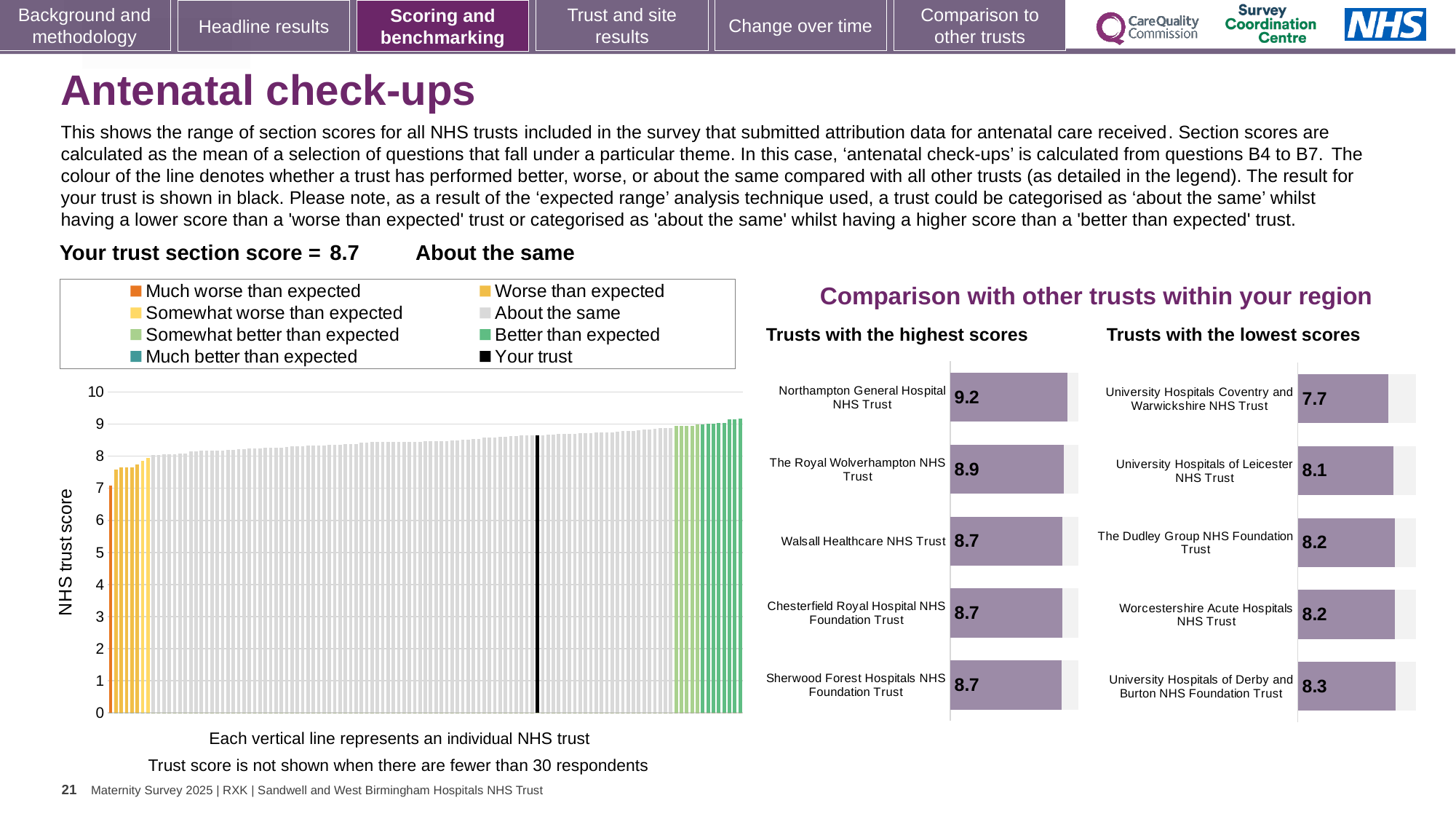
In the 'Trusts with the lowest scores' chart, what is the difference between the scores of University Hospitals of Derby and Burton NHS Foundation Trust and University Hospitals Coventry and Warwickshire NHS Trust? 0.6 What kind of chart is the main 'NHS trust score' chart on the left? Bar chart In the 'Trusts with the highest scores' chart, which trust has the highest score? Northampton General Hospital NHS Trust In the main 'NHS trust score' chart, do the trust scores rise or fall from left to right? Rise In the 'Trusts with the highest scores' chart, what is the difference between the scores of Northampton General Hospital NHS Trust and The Royal Wolverhampton NHS Trust? 0.3 In the 'Trusts with the lowest scores' chart, what is the score for University Hospitals Coventry and Warwickshire NHS Trust? 7.7 In the 'Trusts with the highest scores' chart, what is the score for Northampton General Hospital NHS Trust? 9.2 In the 'Trusts with the lowest scores' chart, which has the larger score: University Hospitals of Leicester NHS Trust or The Dudley Group NHS Foundation Trust? The Dudley Group NHS Foundation Trust How many entries does the legend of the main 'NHS trust score' chart list? 8 How many trusts are shown in the 'Trusts with the highest scores' chart? 5 In the 'Trusts with the lowest scores' chart, which trust has the lowest score? University Hospitals Coventry and Warwickshire NHS Trust In the main 'NHS trust score' chart, is the score of the leftmost (orange) bar greater or less than 8? less